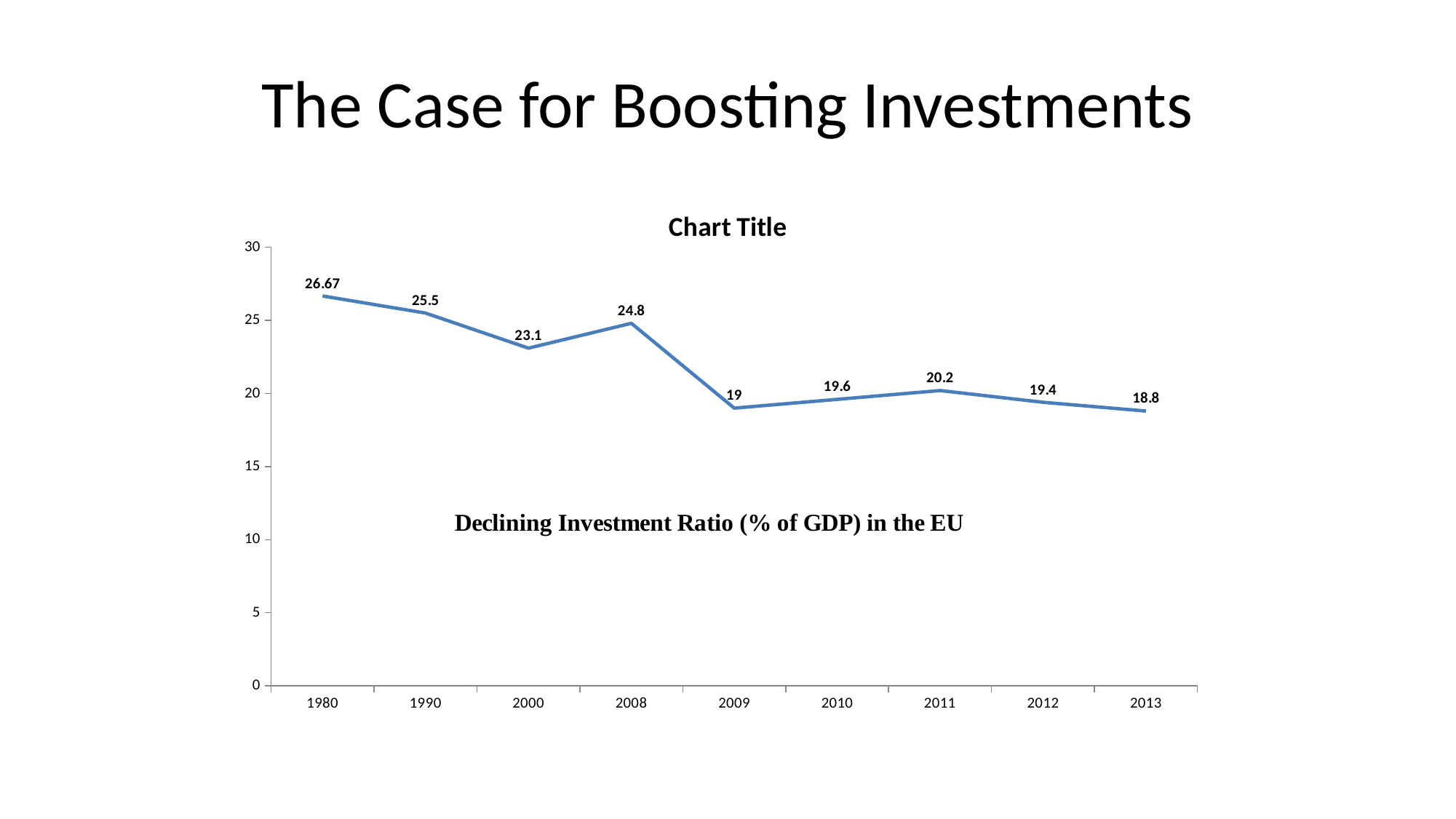
Which is larger, the value for 2000 or the value for 2008? 2008 Is the value for 2011 greater or less than 25? less What is the value plotted for 2013? 18.8 Do the values generally rise or fall from 1980 to 2013? fall What is the investment ratio value for 1980? 26.67 What text label is printed inside the plot area of the chart? Declining Investment Ratio (% of GDP) in the EU Which year has the highest value on the chart? 1980 What is the value plotted for 2009? 19 What kind of chart is shown on the slide? line chart What is the difference between the values for 2008 and 2009? 5.8 How many years are plotted on the x axis? 9 Which year has the lowest value on the chart? 2013